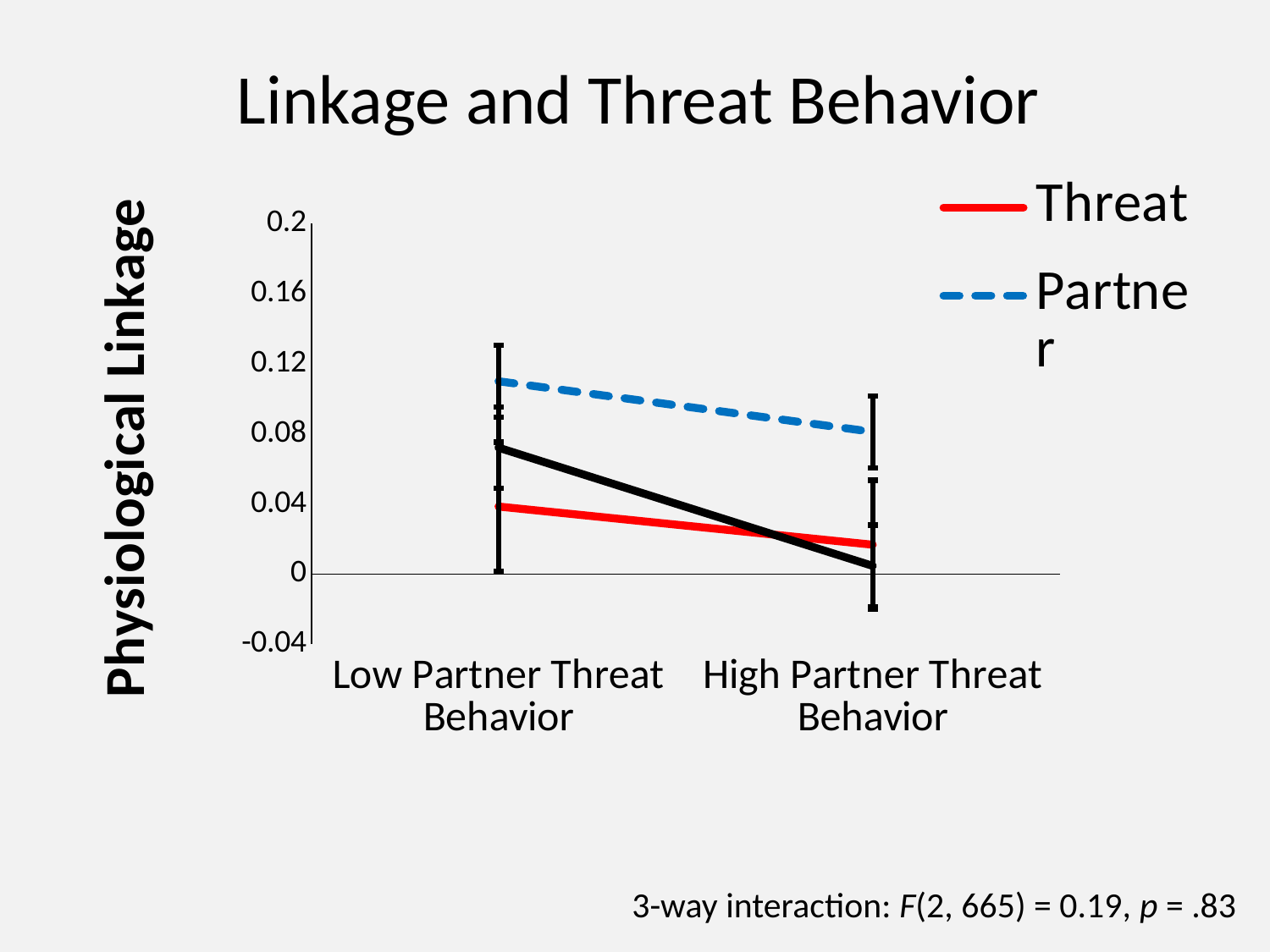
Is the Threat value at High Partner Threat Behavior greater or less than 0.04? less At Low Partner Threat Behavior, which series has the higher value, Threat or Partner? Partner Is the Partner value at Low Partner Threat Behavior greater or less than 0.08? greater How many series does the legend list? 2 Does the Threat line rise or fall from Low Partner Threat Behavior to High Partner Threat Behavior? fall What is the title of the chart? Linkage and Threat Behavior What kind of chart is shown on the slide? line chart Does the Partner line rise or fall from Low Partner Threat Behavior to High Partner Threat Behavior? fall Is the Threat value at Low Partner Threat Behavior greater or less than 0.08? less How many categories are shown on the x axis? 2 At High Partner Threat Behavior, which series has the higher value, Threat or Partner? Partner What is the label of the y axis? Physiological Linkage